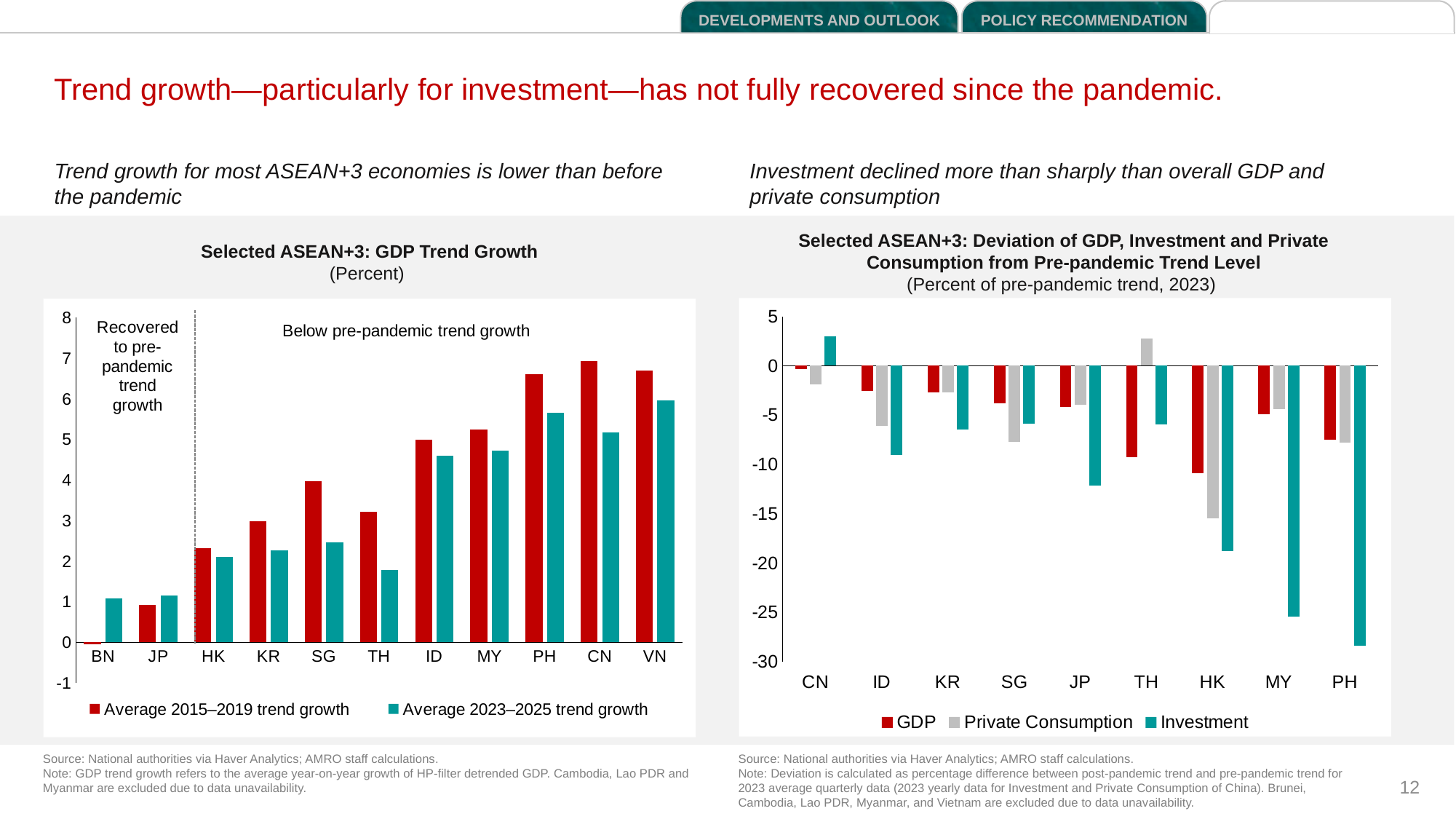
On the right chart, Deviation of GDP, Investment and Private Consumption from Pre-pandemic Trend Level, is the Investment deviation for JP greater or less than -10? less On the left chart, Selected ASEAN+3: GDP Trend Growth, is the average 2015–2019 trend growth for PH greater or less than 6? greater On the left chart, Selected ASEAN+3: GDP Trend Growth, which economy has the highest average 2023–2025 trend growth? VN On the right chart, Deviation of GDP, Investment and Private Consumption from Pre-pandemic Trend Level, which economy has the highest Investment deviation? CN On the left chart, Selected ASEAN+3: GDP Trend Growth, how many economies are shown on the x axis? 11 On the left chart, Selected ASEAN+3: GDP Trend Growth, which economy has the lowest average 2015–2019 trend growth? BN On the left chart, Selected ASEAN+3: GDP Trend Growth, which economies are in the 'Recovered to pre-pandemic trend growth' group? BN and JP What type of chart is the right chart, Deviation of GDP, Investment and Private Consumption from Pre-pandemic Trend Level? Bar chart On the right chart, Deviation of GDP, Investment and Private Consumption from Pre-pandemic Trend Level, how many series does the legend list? 3 On the left chart, Selected ASEAN+3: GDP Trend Growth, is the average 2023–2025 trend growth for SG greater or less than 3? less On the right chart, Deviation of GDP, Investment and Private Consumption from Pre-pandemic Trend Level, which economy has the lowest Investment deviation? PH On the left chart, Selected ASEAN+3: GDP Trend Growth, which is larger for SG: the average 2015–2019 trend growth or the average 2023–2025 trend growth? Average 2015–2019 trend growth